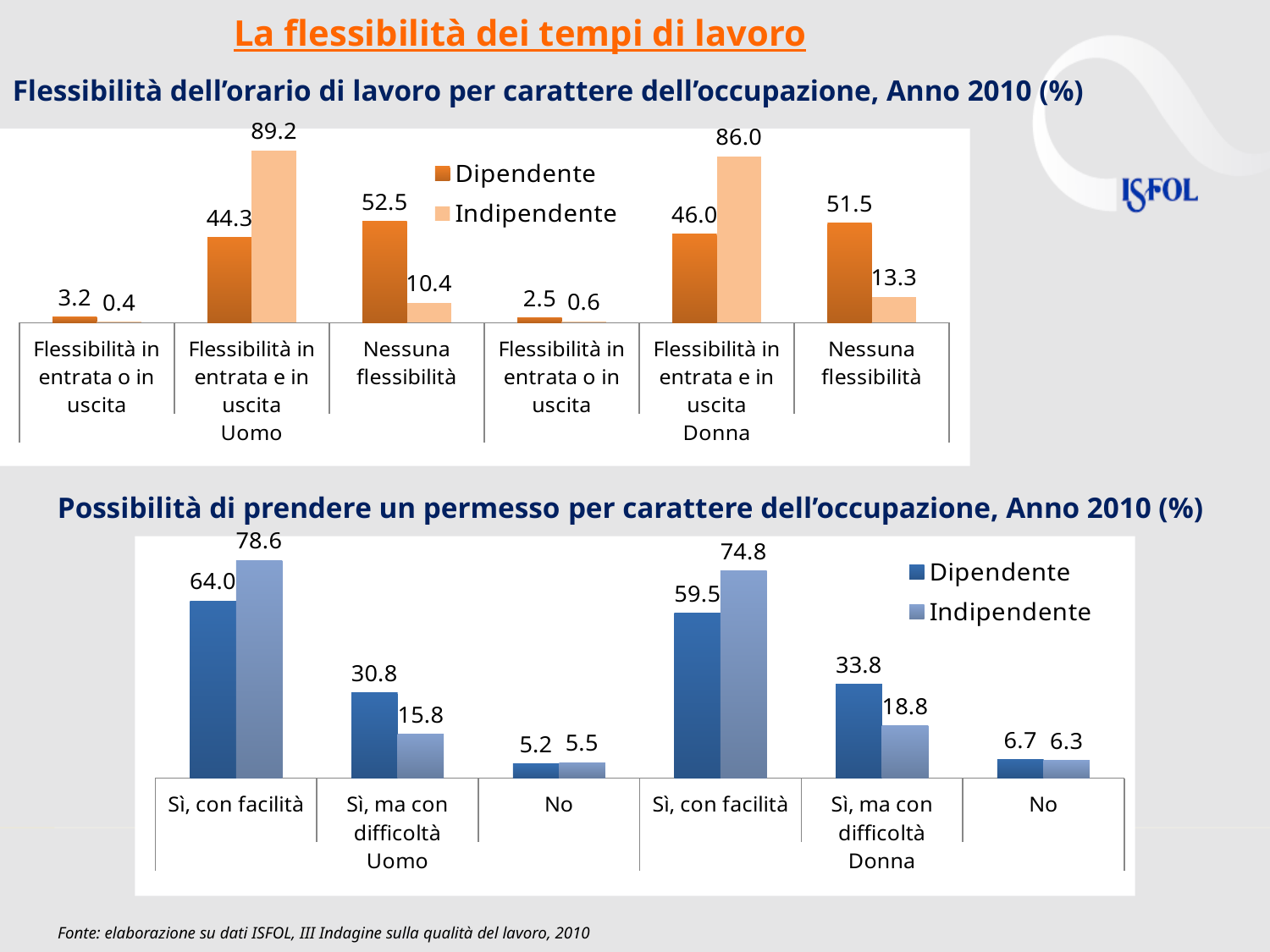
In the top chart (Flessibilità dell'orario di lavoro), what is the Dipendente value for 'Nessuna flessibilità' among Donna? 51.5 In the top chart (Flessibilità dell'orario di lavoro), what is the difference between the Dipendente and Indipendente values for 'Nessuna flessibilità' among Uomo? 42.1 In the bottom chart (Possibilità di prendere un permesso), which is larger for 'No' among Donna: Dipendente or Indipendente? Dipendente In the top chart (Flessibilità dell'orario di lavoro), what is the Indipendente value for 'Flessibilità in entrata e in uscita' among Uomo? 89.2 In the bottom chart (Possibilità di prendere un permesso), how many categories are shown on the x axis? 6 In the bottom chart (Possibilità di prendere un permesso), which category has the lowest Dipendente value? No (Uomo) In the top chart (Flessibilità dell'orario di lavoro), how many series does the legend list? 2 In the bottom chart (Possibilità di prendere un permesso), what is the difference between the Indipendente and Dipendente values for 'Sì, con facilità' among Uomo? 14.6 In the top chart (Flessibilità dell'orario di lavoro), which category has the highest Indipendente value? Flessibilità in entrata e in uscita (Uomo) What kind of chart is the bottom chart (Possibilità di prendere un permesso)? Bar chart In the bottom chart (Possibilità di prendere un permesso), what is the Dipendente value for 'Sì, ma con difficoltà' among Uomo? 30.8 In the bottom chart (Possibilità di prendere un permesso), what is the Indipendente value for 'Sì, con facilità' among Donna? 74.8